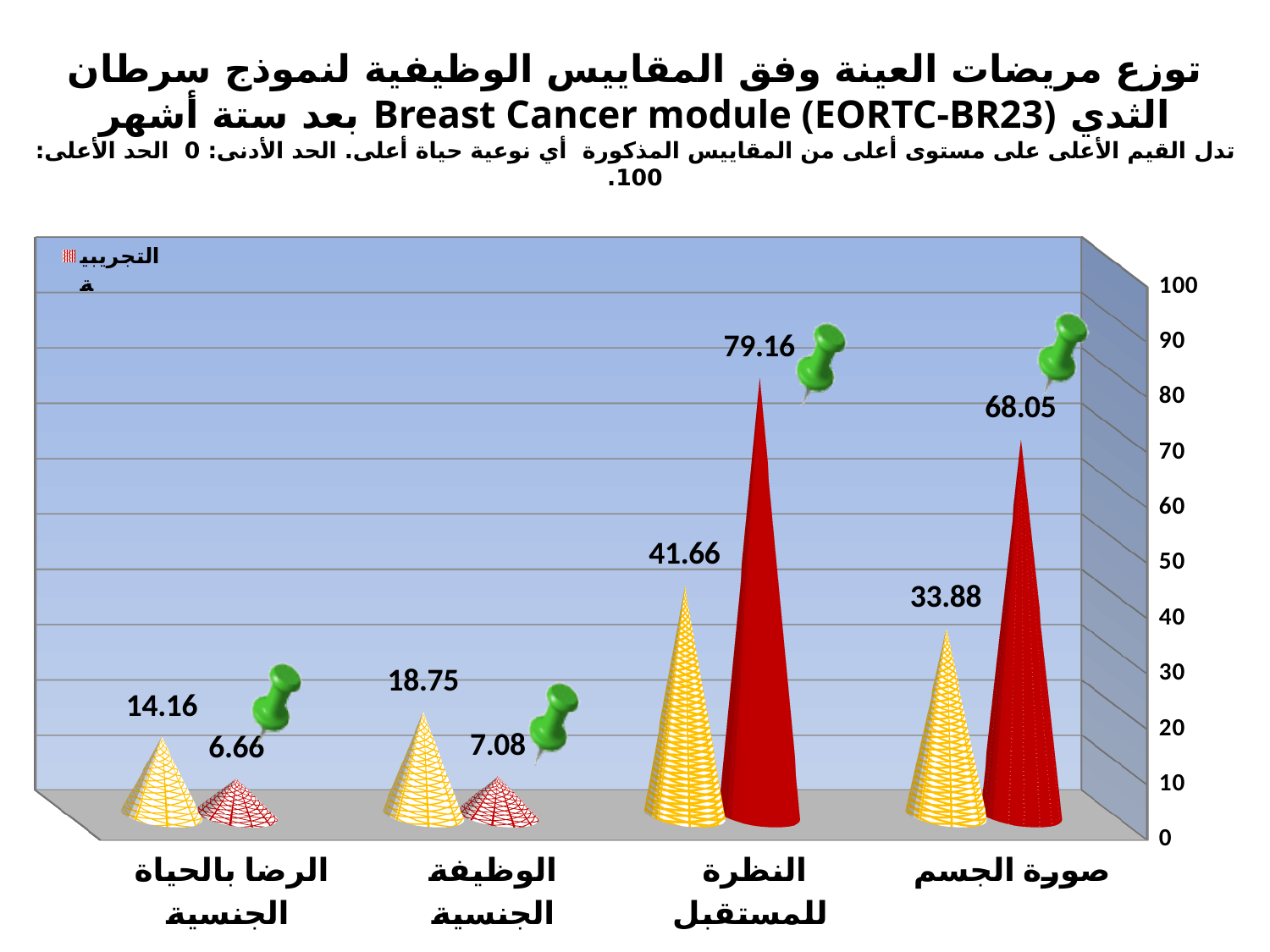
What is the value of the yellow cone for الرضا بالحياة الجنسية? 14.16 What kind of chart is shown on the slide? bar chart What is the value of the yellow cone for النظرة للمستقبل? 41.66 Which category has the highest red cone value? النظرة للمستقبل What is the value of the red cone for صورة الجسم? 68.05 What is the value of the red cone for الوظيفة الجنسية? 7.08 How many categories are shown on the x axis? 4 Is the red cone value for النظرة للمستقبل greater or less than 70? greater What is the difference between the red and yellow cone values for صورة الجسم? 34.17 What is the difference between the yellow and red cone values for الوظيفة الجنسية? 11.67 Which category has the lowest red cone value? الرضا بالحياة الجنسية For النظرة للمستقبل, which is larger: the yellow cone or the red cone? the red cone